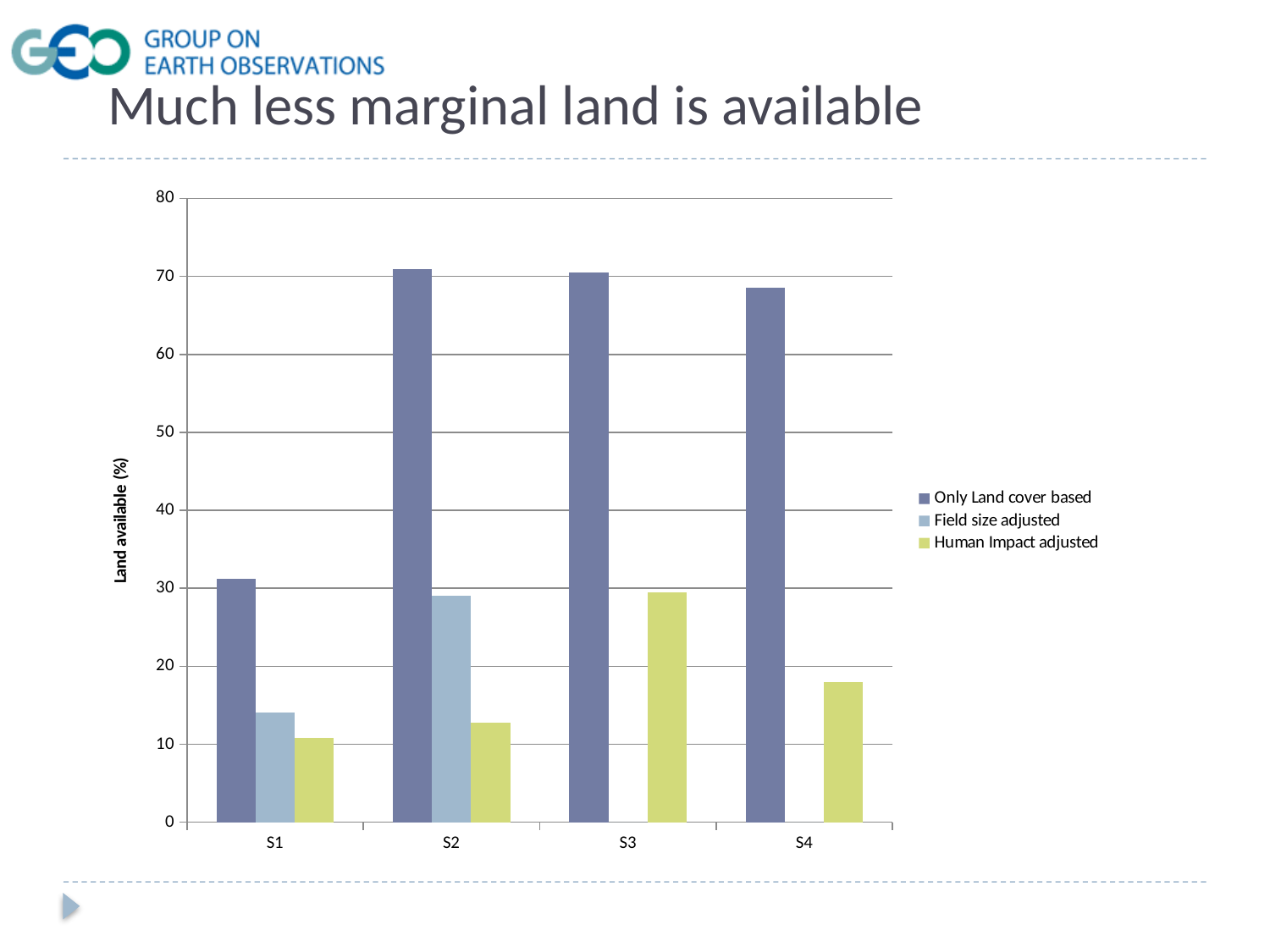
Which category has the lowest value for Only Land cover based? S1 How many series does the legend list? 3 Which category has the highest value for Human Impact adjusted? S3 Which is larger for S3, the Only Land cover based value or the Human Impact adjusted value? Only Land cover based Is the Only Land cover based value for S1 greater or less than 20? greater Is the Human Impact adjusted value for S4 greater or less than 20? less Which series is shown in yellow-green? Human Impact adjusted How many categories are shown on the x axis? 4 What kind of chart is shown on the slide? bar chart Is the Only Land cover based value for S2 greater or less than 60? greater Which is larger, the Field size adjusted value for S1 or for S2? S2 What is the label of the y axis? Land available (%)